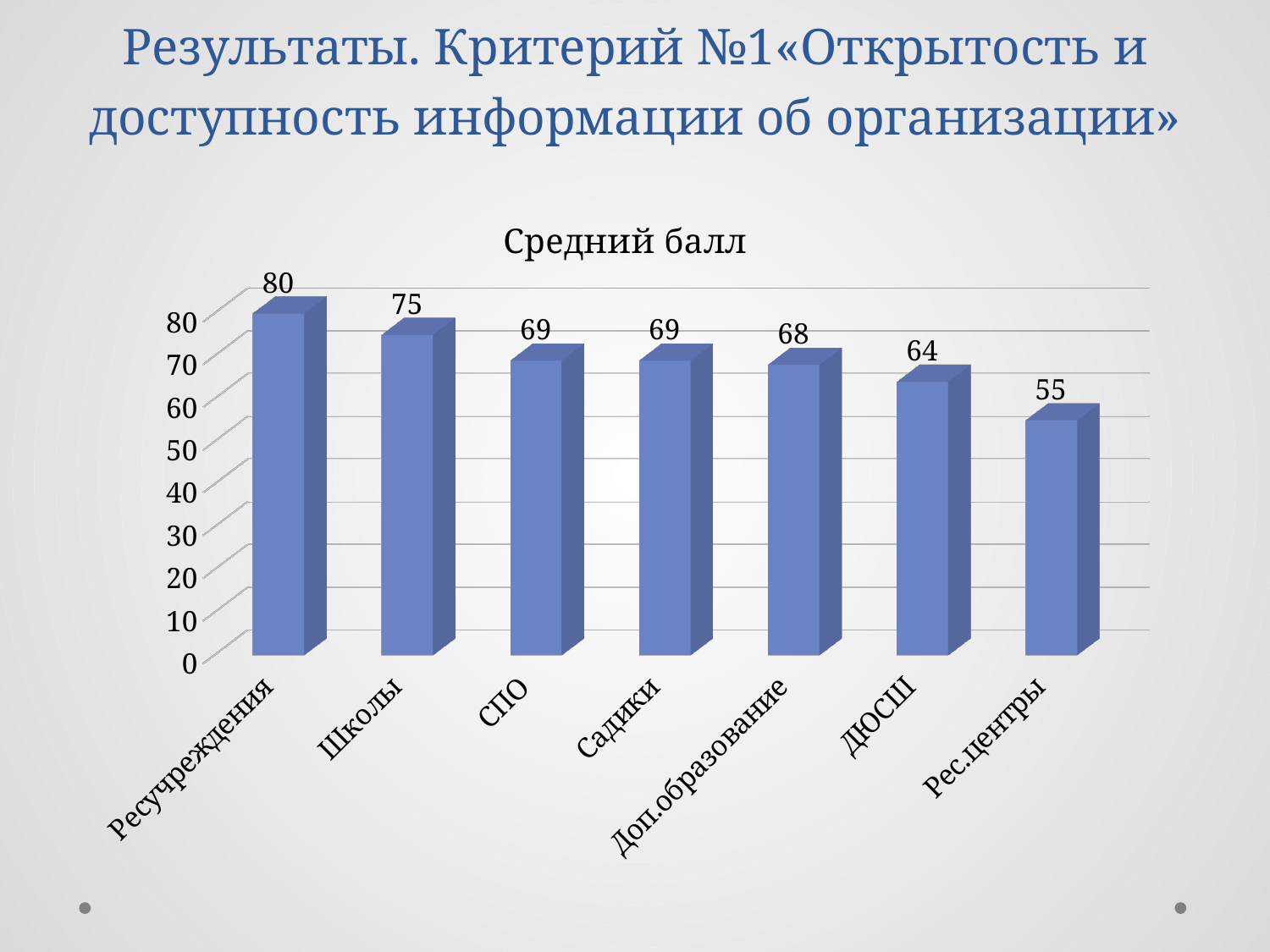
What is the value for Школы? 75 What is the value for Рес.центры? 55 What is the title of the chart? Средний балл Which category has the highest value? Ресучреждения What is the difference between the values for Школы and ДЮСШ? 11 What is the value for Доп.образование? 68 What kind of chart is shown on the slide? bar chart Is the value for ДЮСШ greater or less than 60? greater What is the difference between the values for Ресучреждения and Рес.центры? 25 Which is larger, the value for Школы or the value for ДЮСШ? Школы Which category has the lowest value? Рес.центры How many categories are shown on the chart? 7